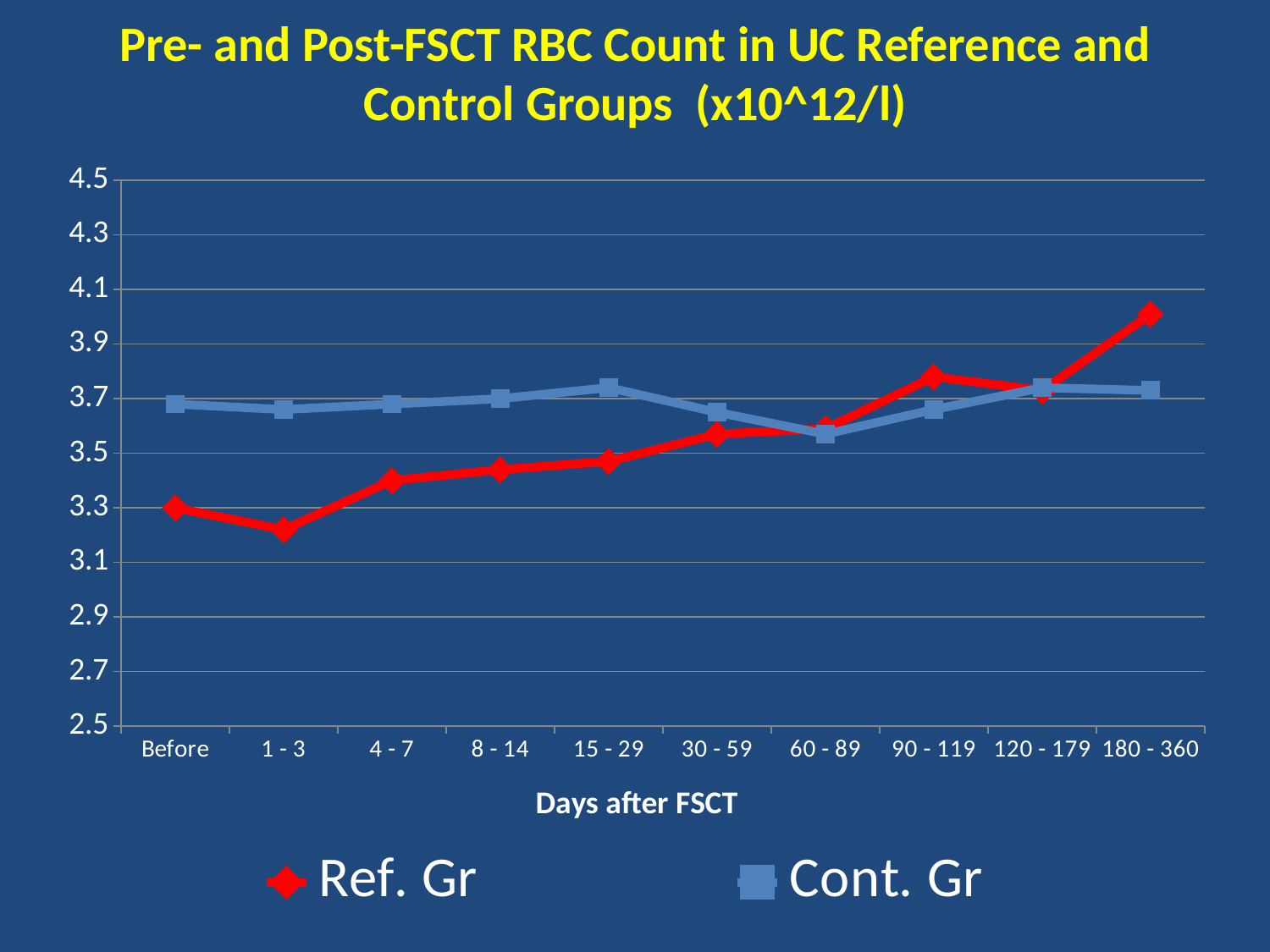
At which category does the Ref. Gr series reach its highest value? 180 - 360 What is the title of the x axis? Days after FSCT Is the value for Ref. Gr at '180 - 360' greater or less than 3.9? greater Which series has the higher value at '180 - 360', Ref. Gr or Cont. Gr? Ref. Gr What kind of chart is shown on the slide? line chart At which category does the Ref. Gr series have its lowest value? 1 - 3 Is the value for Cont. Gr at '60 - 89' greater or less than 3.7? less How many categories are shown along the x axis? 10 Which series has the higher value at 'Before', Ref. Gr or Cont. Gr? Cont. Gr How many series does the legend list? 2 Is the value for Ref. Gr at 'Before' greater or less than 3.5? less Does the Ref. Gr series generally rise or fall from 'Before' to '180 - 360'? rise